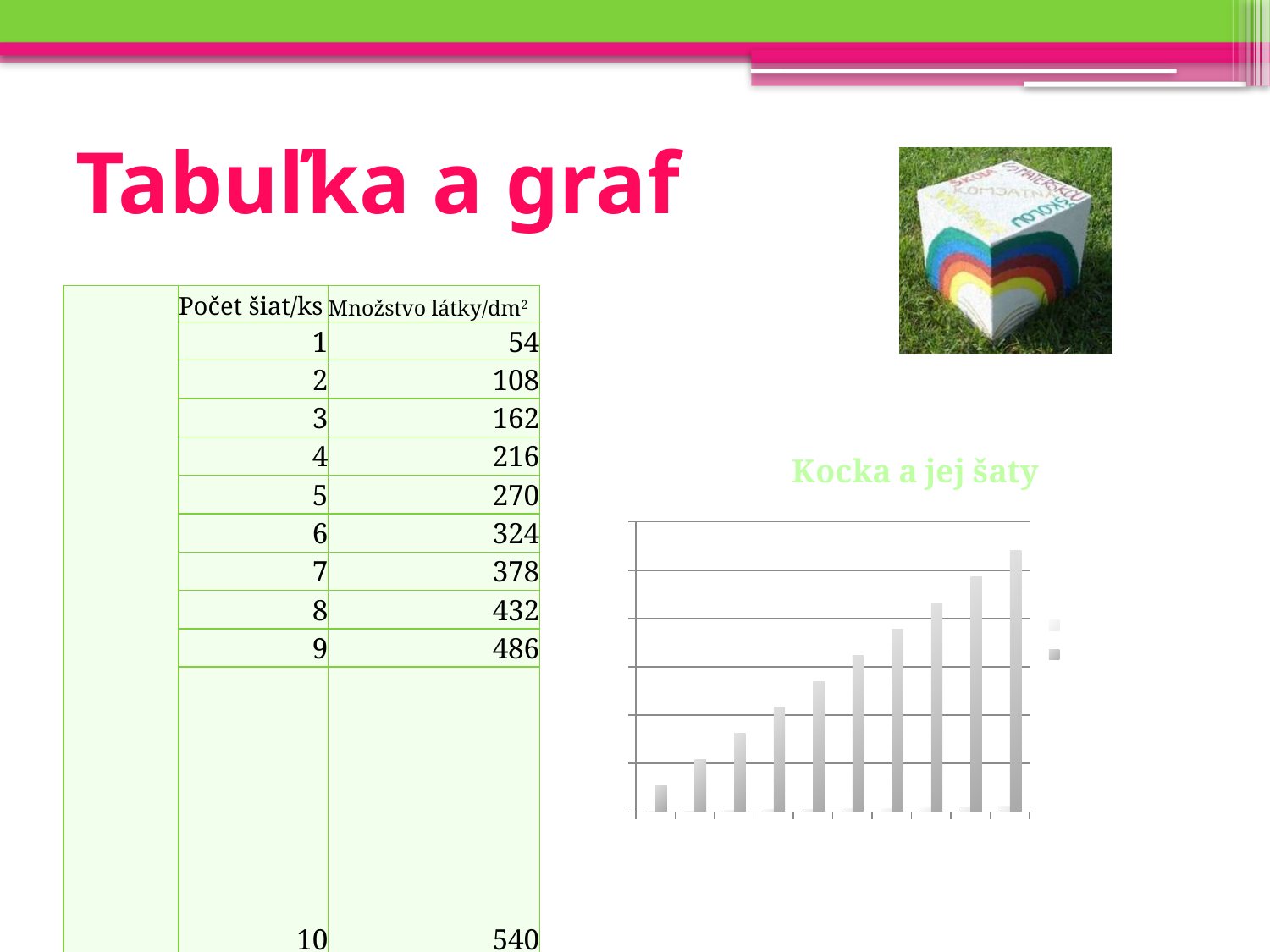
In the "Kocka a jej šaty" chart, do the bar values rise or fall from left to right? rise How many bars are plotted in the "Kocka a jej šaty" chart? 10 In the "Kocka a jej šaty" chart, which bar is the tallest? the rightmost (tenth) bar Are the bars in the "Kocka a jej šaty" chart vertical or horizontal? vertical What kind of chart is shown under the title "Kocka a jej šaty"? bar chart In the "Kocka a jej šaty" chart, which is taller: the third bar from the left or the seventh bar from the left? the seventh bar In the "Kocka a jej šaty" chart, which is taller: the ninth bar from the left or the second bar from the left? the ninth bar What is the title of the chart on the right side of the slide? Kocka a jej šaty In the "Kocka a jej šaty" chart, which bar is the shortest? the leftmost (first) bar